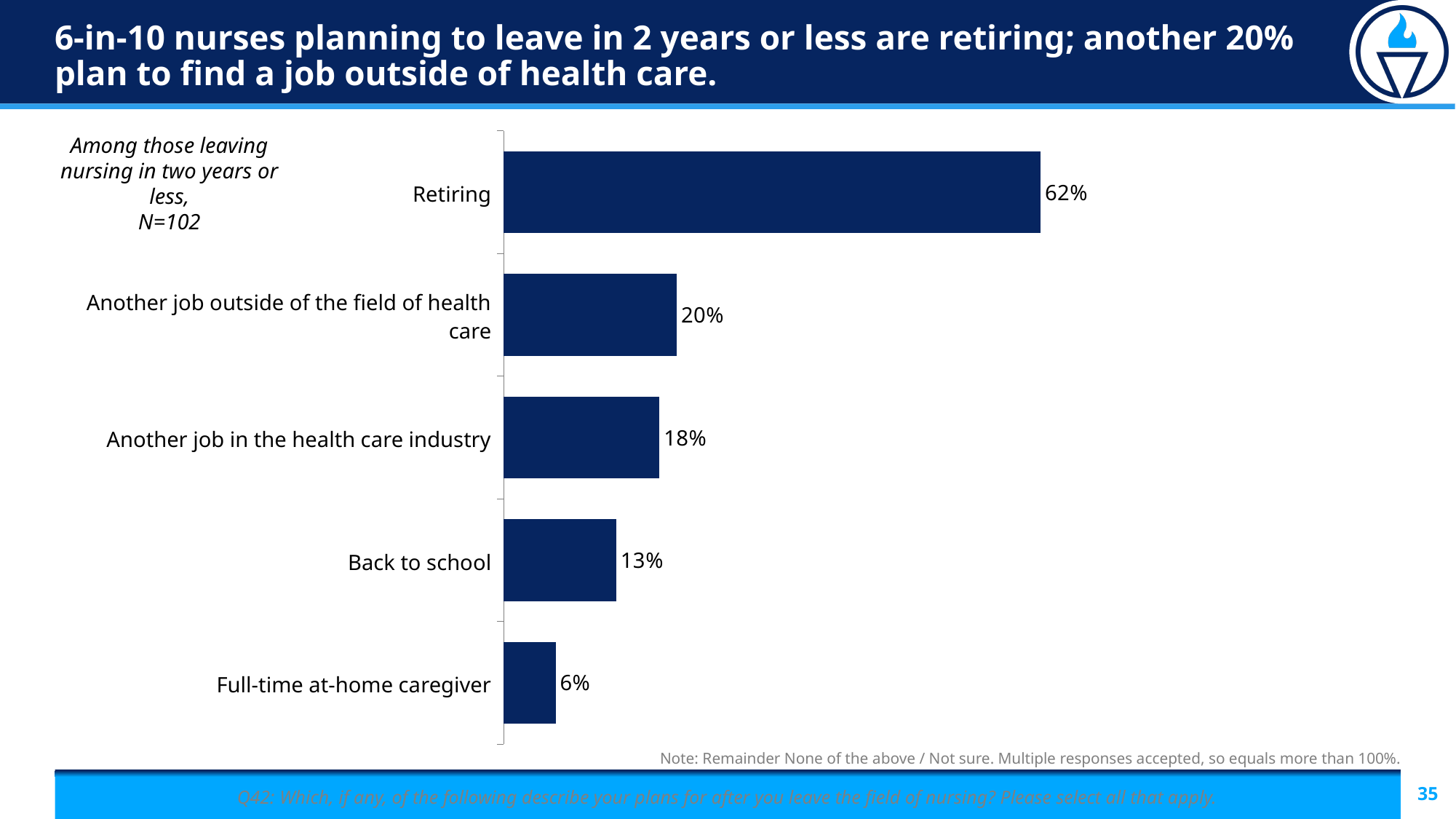
Which category has the highest value? Retiring What percentage of nurses leaving nursing in two years or less say they are retiring? 62% What is the difference between 'Another job in the health care industry' and 'Back to school'? 5% Which is larger: 'Another job outside of the field of health care' or 'Another job in the health care industry'? Another job outside of the field of health care What is the value for 'Full-time at-home caregiver'? 6% What is the sample size (N) stated for the chart? N=102 What is the value for 'Back to school'? 13% Which category has the lowest value? Full-time at-home caregiver What kind of chart is shown on the slide? Bar chart What is the value for 'Another job outside of the field of health care'? 20% How many categories are shown in the chart? 5 What is the difference between the values for 'Retiring' and 'Another job outside of the field of health care'? 42%